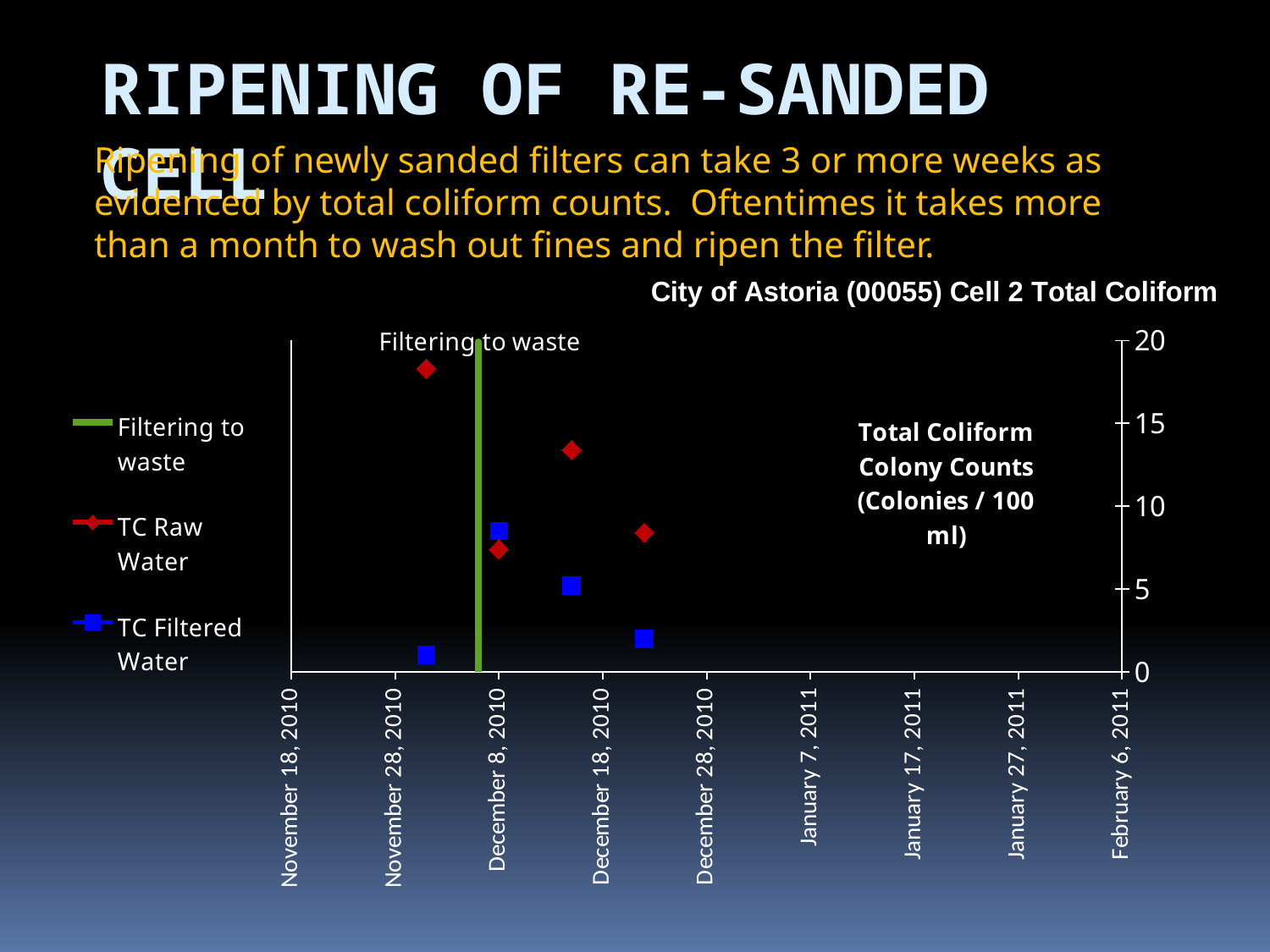
Is the highest TC Filtered Water value greater or less than 10? less How many TC Raw Water data points are plotted on the chart? 4 Is the earliest TC Filtered Water value (around late November 2010) greater or less than 5? less How many TC Filtered Water data points are plotted on the chart? 4 At the last plotted date (around December 22, 2010), which is larger: TC Raw Water or TC Filtered Water? TC Raw Water What is the title of the chart? City of Astoria (00055) Cell 2 Total Coliform Do the TC Filtered Water values rise or fall over the three points after the Filtering to waste line? fall Is the highest TC Raw Water value greater or less than 15? greater How many entries does the chart legend list? 3 Which series contains the lowest plotted value on the chart? TC Filtered Water Which series contains the highest plotted value on the chart? TC Raw Water What kind of chart is shown on the slide? Scatter chart